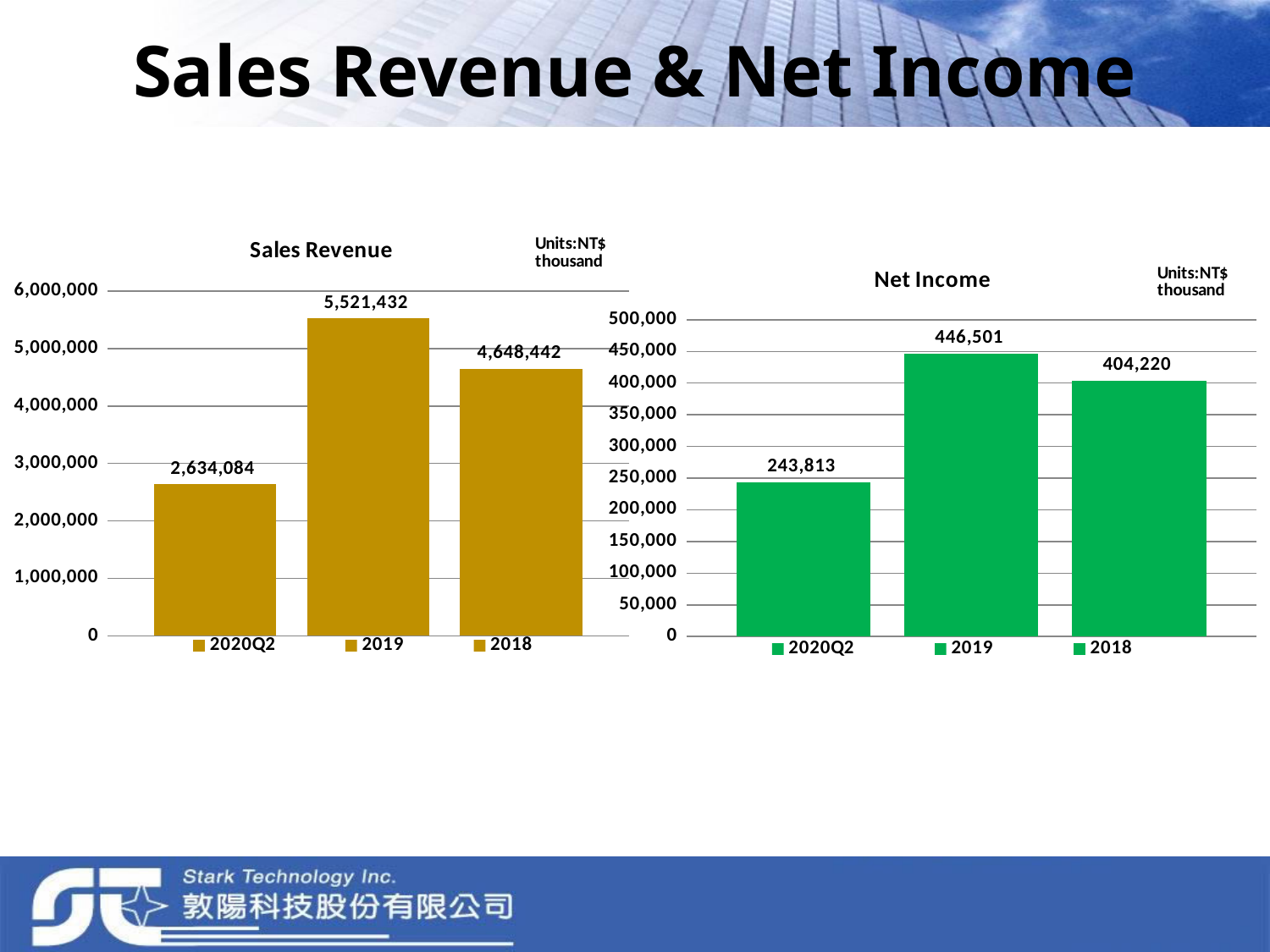
In the Net Income chart, what is the value for 2020Q2? 243,813 In the Sales Revenue chart, which category has the lowest value? 2020Q2 In the Sales Revenue chart, what is the value for 2019? 5,521,432 In the Sales Revenue chart, what is the value for 2018? 4,648,442 In the Net Income chart, which category has the highest value? 2019 In the Sales Revenue chart, is the value for 2020Q2 greater or less than 3,000,000? less How many bars are plotted in the Net Income chart? 3 In the Net Income chart, which is larger, the value for 2018 or the value for 2020Q2? 2018 What kind of chart is the Sales Revenue chart? bar chart In the Sales Revenue chart, what is the difference between the 2019 and 2018 values? 872,990 In the Net Income chart, what is the difference between the 2019 and 2018 values? 42,281 What units are stated for the Net Income chart? NT$ thousand